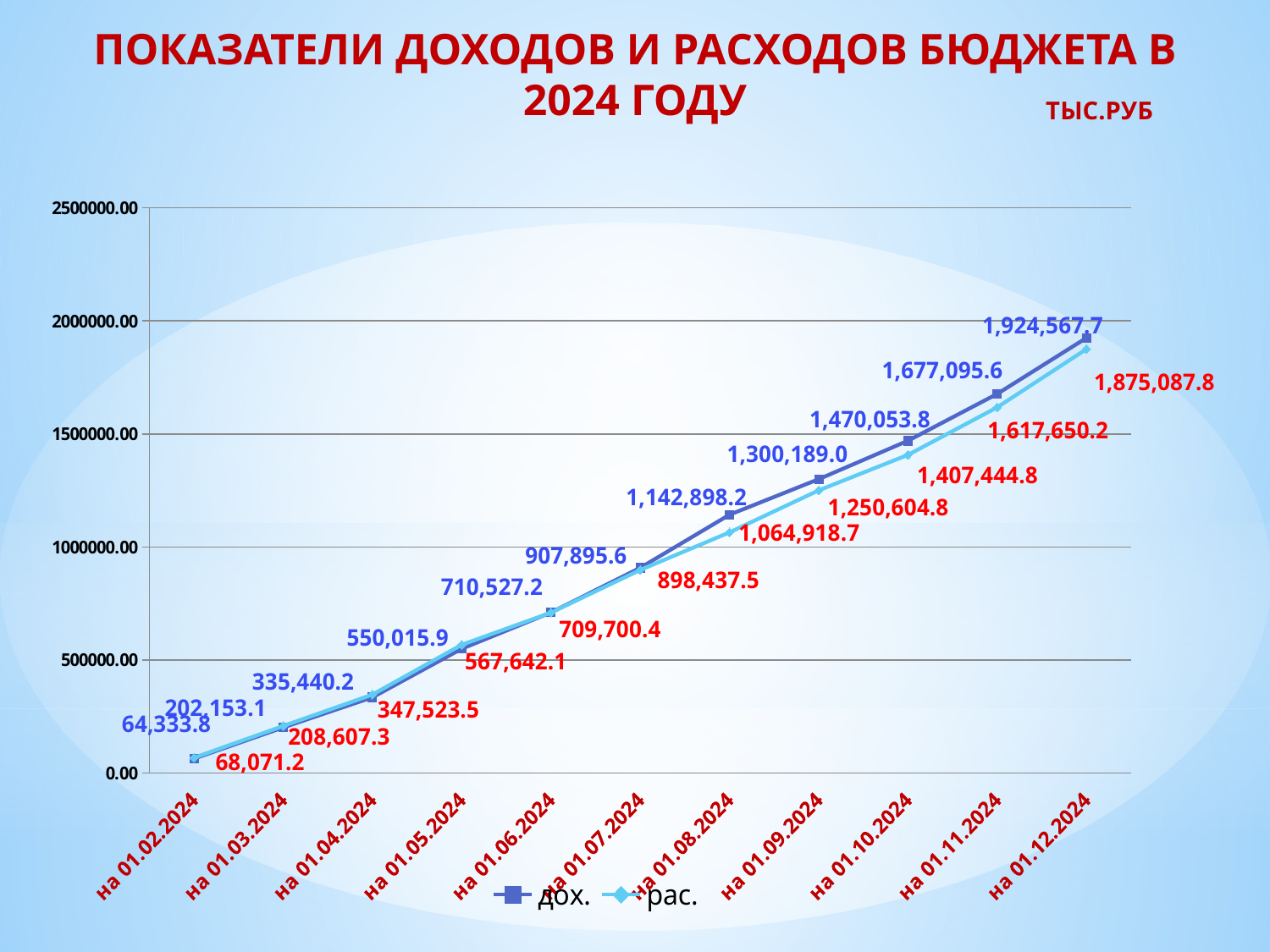
What is the value of the рас. series on 01.08.2024? 1,064,918.7 How many series does the legend list? 2 What is the value of the дох. series on 01.12.2024? 1,924,567.7 At which date is the дох. series at its lowest value? на 01.02.2024 What is the difference between дох. and рас. on 01.12.2024? 49,479.9 Is the value of дох. on 01.09.2024 greater or less than 1000000.00? greater How many dates are plotted on the x axis? 11 At which date does the рас. series reach its highest value? на 01.12.2024 On 01.05.2024, which series has the larger value, дох. or рас.? рас. What is the value of the дох. series on 01.02.2024? 64,333.8 What kind of chart is shown on the slide? line chart Do the values of the дох. series rise or fall from 01.02.2024 to 01.12.2024? rise